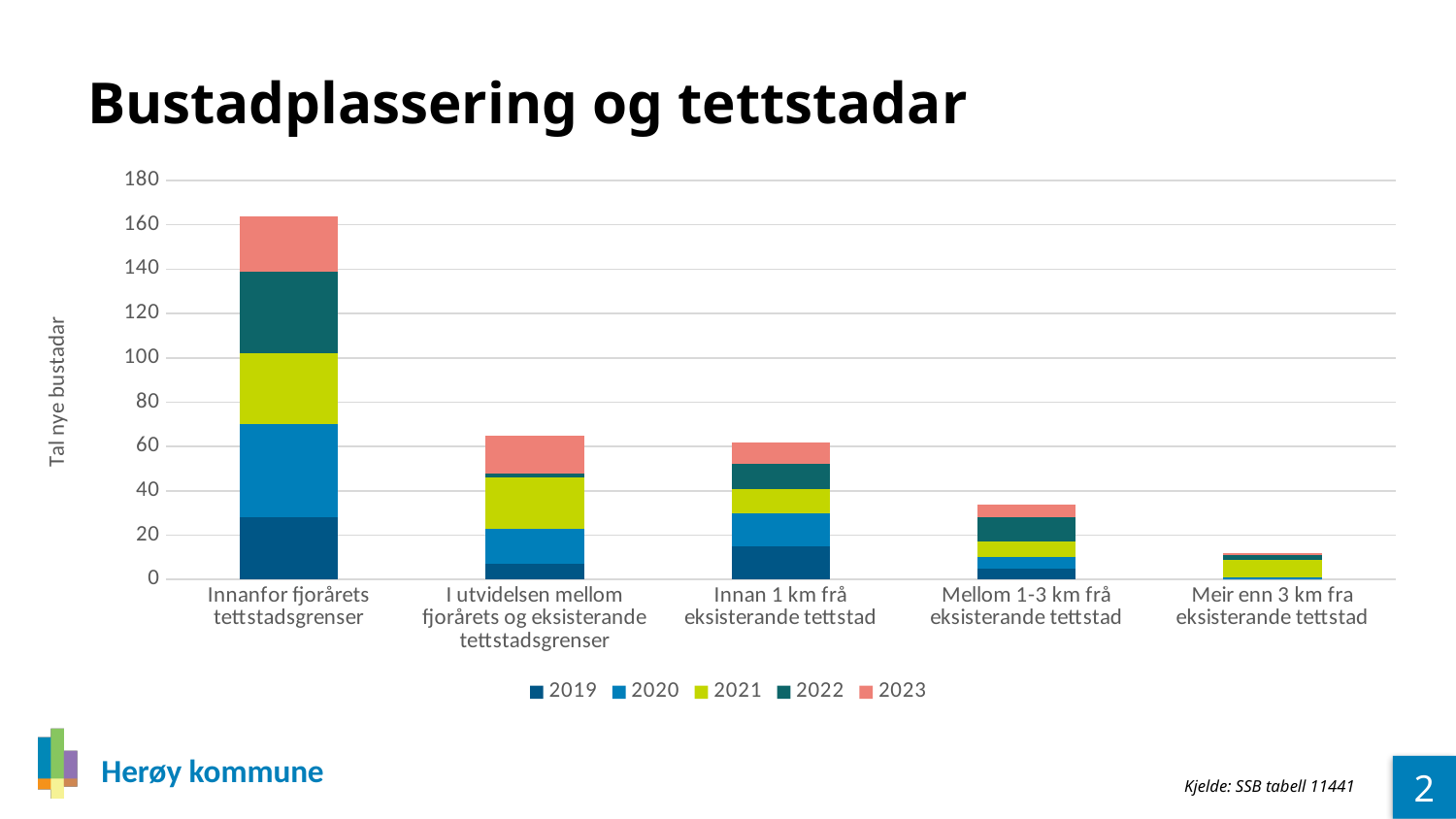
Is the total stacked value for 'Meir enn 3 km fra eksisterande tettstad' greater or less than 20? less Which category has the shortest stacked bar? Meir enn 3 km fra eksisterande tettstad Is the total stacked value for 'Mellom 1-3 km frå eksisterande tettstad' greater or less than 40? less Is the total stacked value for 'Innan 1 km frå eksisterande tettstad' greater or less than 80? less What kind of chart is shown on the slide? Stacked bar chart How many series does the legend list? 5 Which has the larger total: 'Mellom 1-3 km frå eksisterande tettstad' or 'Meir enn 3 km fra eksisterande tettstad'? Mellom 1-3 km frå eksisterande tettstad What is the title of the chart on the slide? Bustadplassering og tettstadar Which category has the tallest stacked bar? Innanfor fjorårets tettstadsgrenser How many categories are shown on the x axis of the chart? 5 What is the label of the vertical axis? Tal nye bustadar